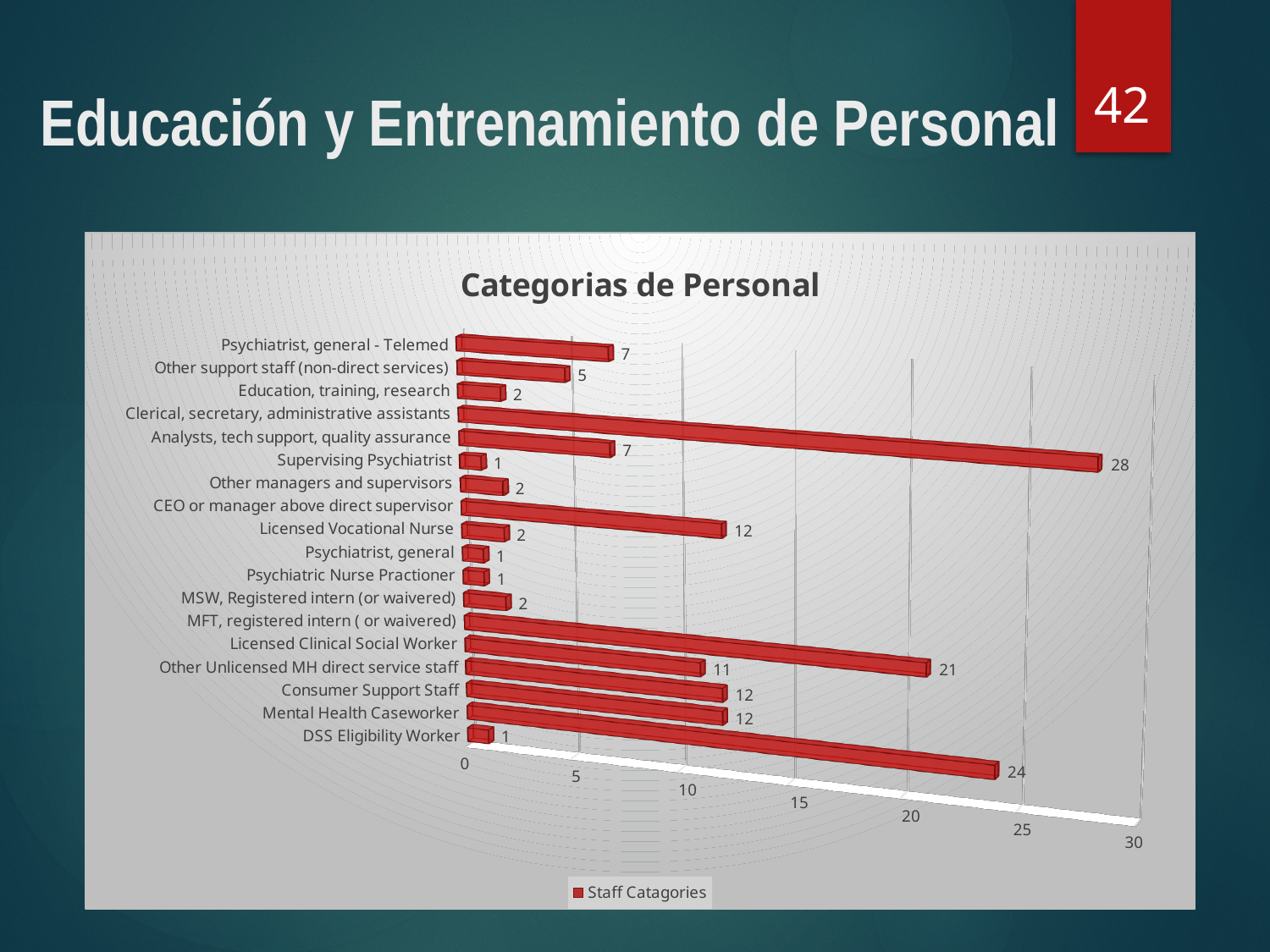
What is the name of the series listed in the chart legend? Staff Catagories Which has a larger value, MFT, registered intern ( or waivered) or CEO or manager above direct supervisor? MFT, registered intern ( or waivered) What is the value for Clerical, secretary, administrative assistants? 28 What is the value for Licensed Clinical Social Worker? 11 What is the value for Mental Health Caseworker? 24 Which staff category has the highest value? Clerical, secretary, administrative assistants What type of chart is shown on the slide? bar chart What is the value for Other support staff (non-direct services)? 5 What is the title of the chart? Categorias de Personal What is the difference between the values for Clerical, secretary, administrative assistants and Mental Health Caseworker? 4 How many staff categories are plotted in the chart? 18 How many series does the legend list? 1